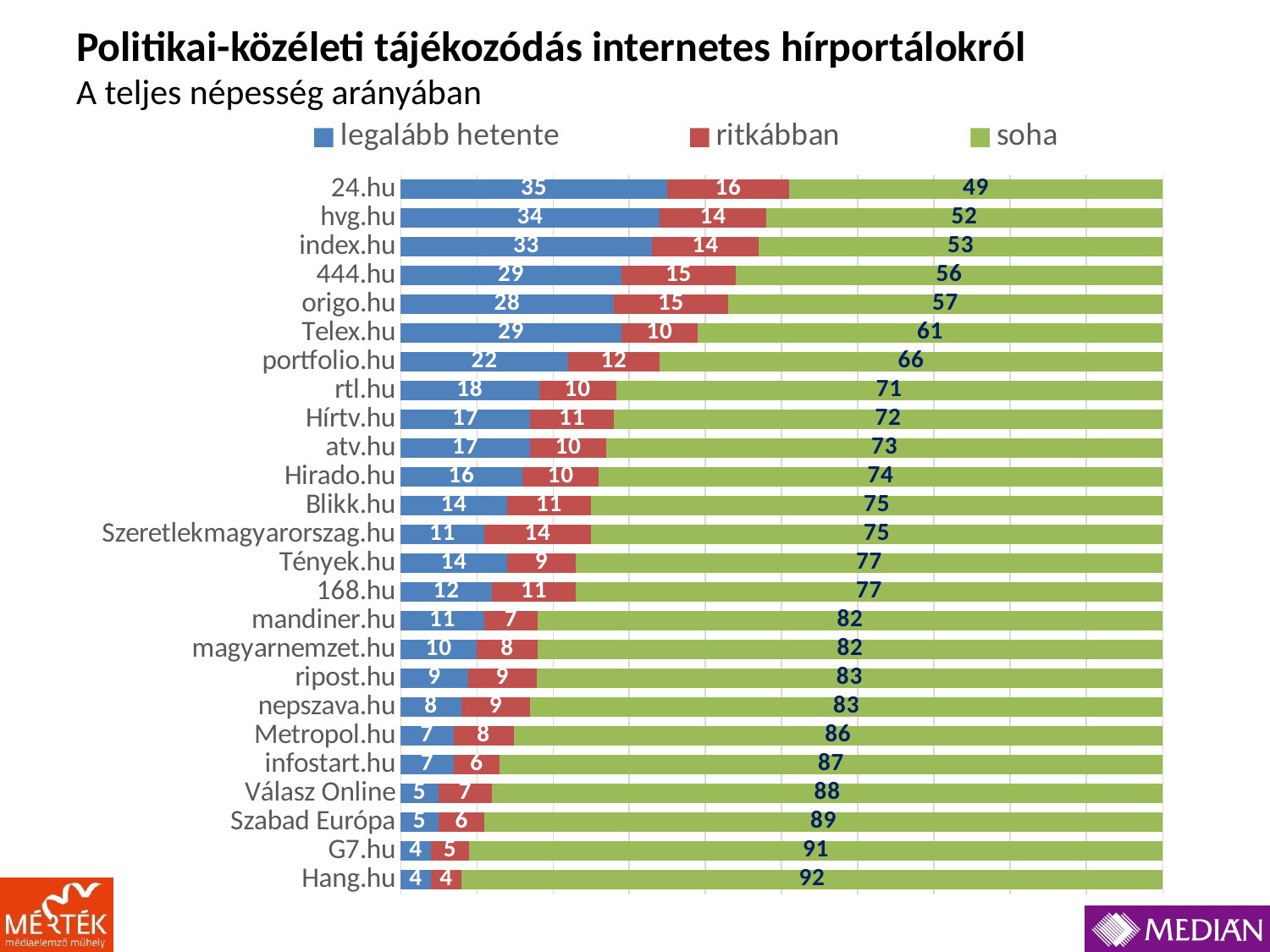
Which portal has the highest 'legalább hetente' value? 24.hu What is the 'ritkábban' value for Szeretlekmagyarorszag.hu? 14 What kind of chart is shown on the slide? Stacked bar chart What is the 'soha' value for Telex.hu? 61 What is the difference between the 'soha' values for Hang.hu and 24.hu? 43 What is the title of the chart? Politikai-közéleti tájékozódás internetes hírportálokról Which is larger: the 'legalább hetente' value for origo.hu or for Telex.hu? Telex.hu How many news portals (categories) are shown in the chart? 25 Which portal has the highest 'soha' value? Hang.hu What is the total of the stacked bar for portfolio.hu? 100 What is the 'legalább hetente' value for 24.hu? 35 How many series does the legend list? 3